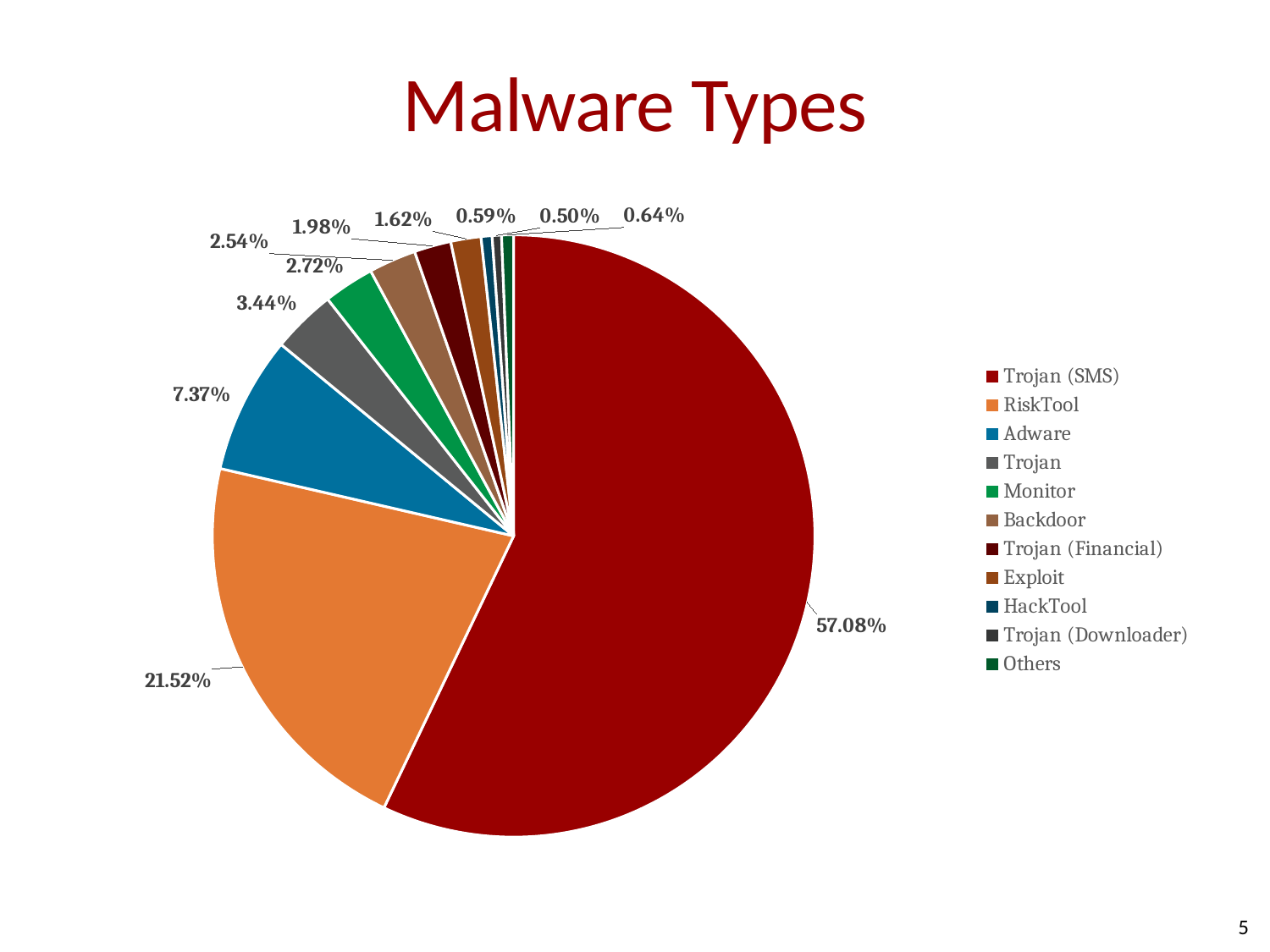
What is the value shown for RiskTool? 21.52% Which malware type has the smallest slice of the pie? Trojan (Downloader) What is the title of the chart? Malware Types What is the difference between the Trojan (SMS) share and the RiskTool share? 35.56% Which malware type has the largest slice of the pie? Trojan (SMS) What share of the pie does Trojan (SMS) account for? 57.08% What is the value shown for Monitor? 2.72% Which is larger, the share for Adware or the share for Trojan? Adware What is the value shown for Adware? 7.37% What kind of chart is shown on the slide? pie chart How many categories does the legend list? 11 What colour is the slice for RiskTool? orange